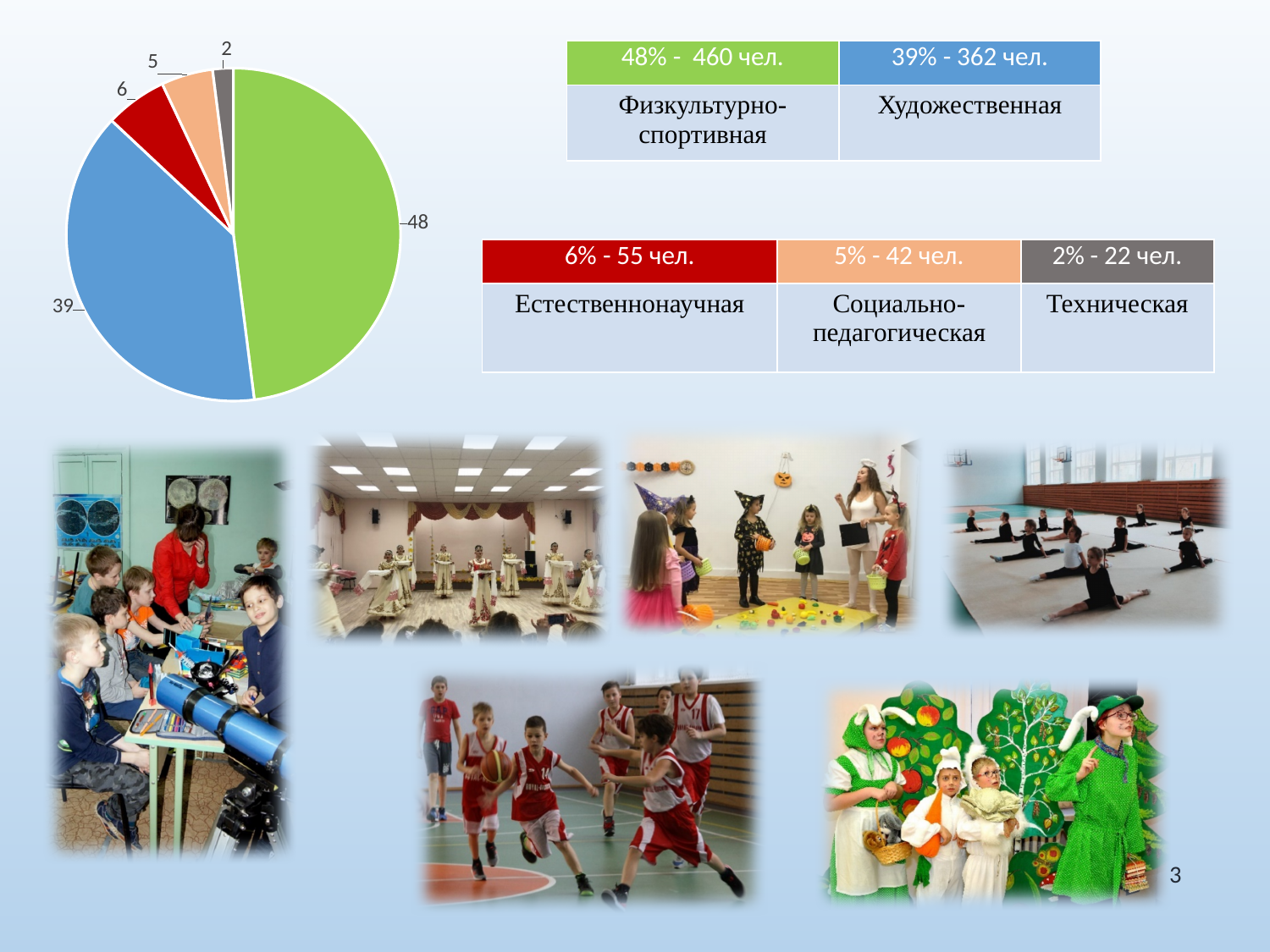
How many slices does the pie chart have? 5 What kind of chart is shown on the slide? pie chart What share of the pie does the Художественная category represent? 39% What value is labelled on the blue slice of the pie chart? 39 Which category has the smallest slice of the pie chart? Техническая What is the difference between the values of the green slice (48) and the blue slice (39)? 9 Which slice is larger: the red one (Естественнонаучная) or the peach one (Социально-педагогическая)? Естественнонаучная What colour is the largest slice of the pie chart? green Which category has the largest slice of the pie chart? Физкультурно-спортивная How many people (чел.) are in the Физкультурно-спортивная category according to the slide? 460 чел. What value is labelled on the green slice of the pie chart? 48 What is the difference between the values of the red slice (6) and the grey slice (2)? 4